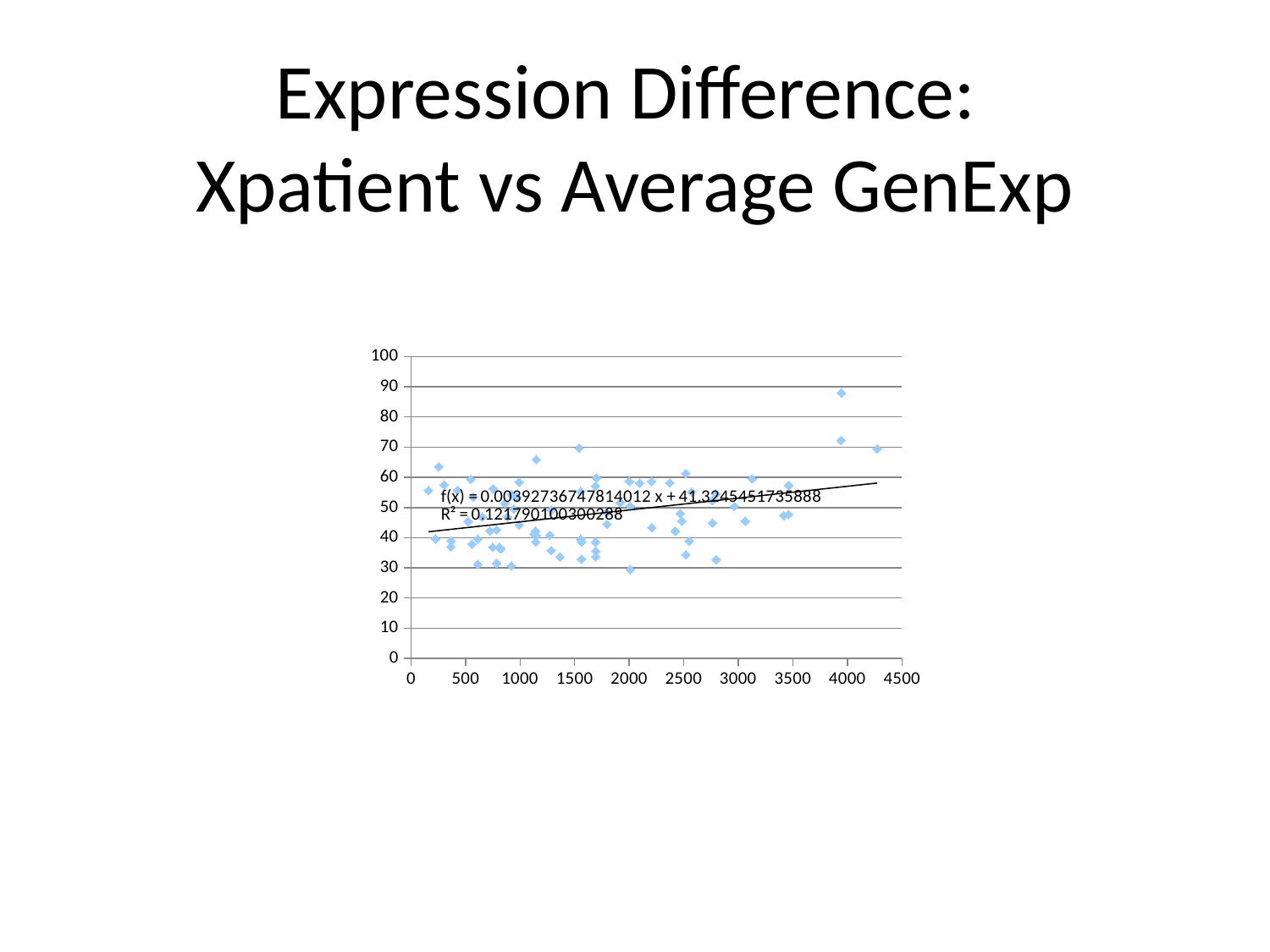
What is the trendline equation printed on the chart? f(x) = 0.00392736747814012 x + 41.3245451735888 What is the intercept of the trendline equation shown on the chart? 41.3245451735888 Is the trendline's value at x = 4000 greater or less than 50? greater What kind of chart is shown on the slide? scatter chart Is the lowest plotted point on the chart greater or less than 40? less Is the highest plotted point located at an x value greater or less than 3500? greater What is the slope of the trendline equation shown on the chart? 0.00392736747814012 What is the title of the slide containing the chart? Expression Difference: Xpatient vs Average GenExp According to the trendline, do the values tend to rise or fall as x increases? rise What is the maximum value shown on the y axis? 100 What is the R² value printed on the chart? 0.121790100300288